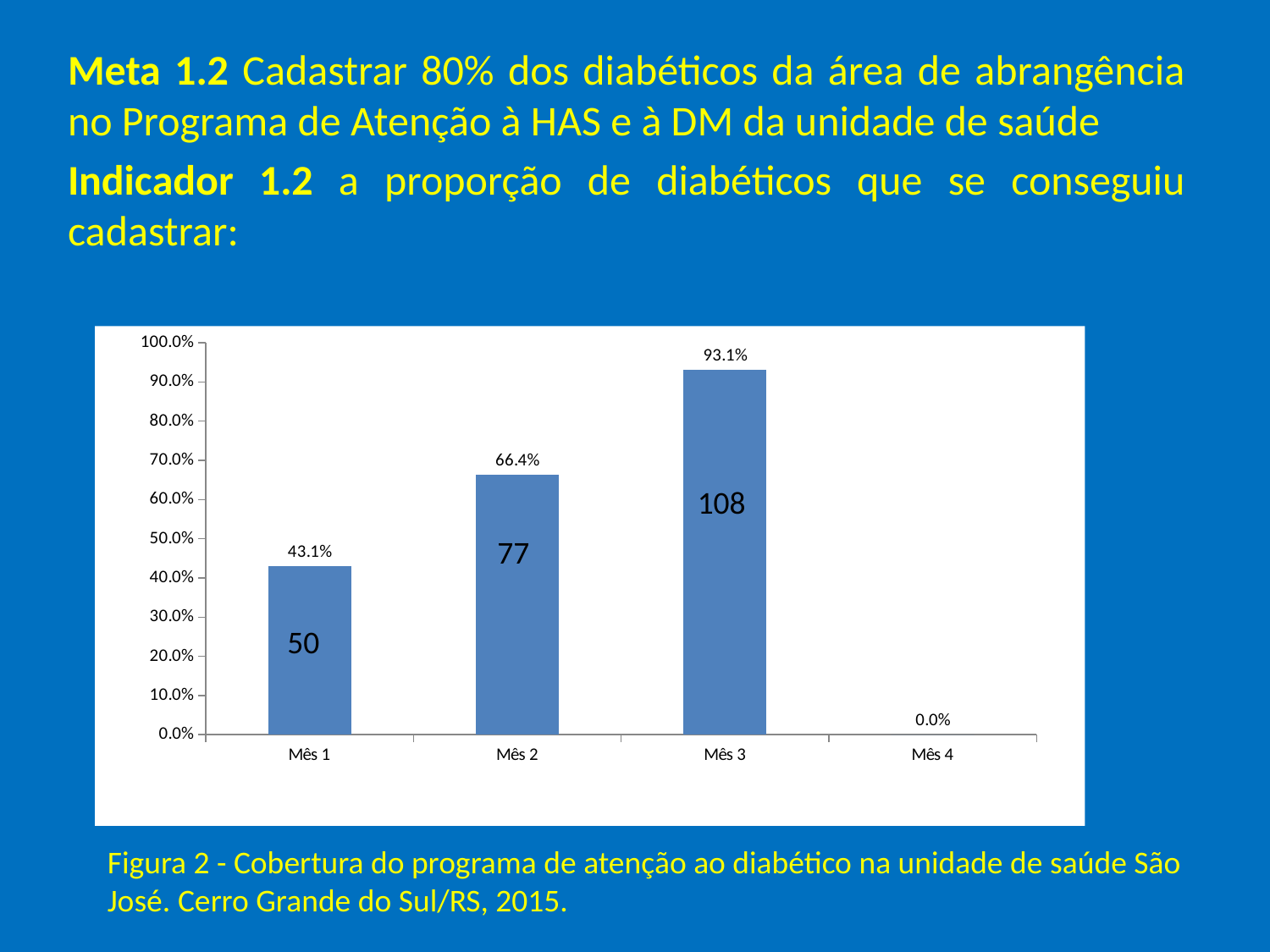
How many months are shown on the x axis? 4 Which month has the highest percentage value? Mês 3 What kind of chart is shown on the slide? Bar chart Which month has the lowest percentage value? Mês 4 Which is larger, the value for Mês 1 or the value for Mês 2? Mês 2 What is the difference in percentage points between Mês 3 and Mês 2? 26.7 What is the percentage value shown for Mês 2? 66.4% What is the percentage value shown for Mês 4? 0.0% What is the percentage value shown for Mês 1? 43.1% What is the percentage value shown for Mês 3? 93.1% What number is printed inside the bar for Mês 1? 50 What number is printed inside the bar for Mês 3? 108